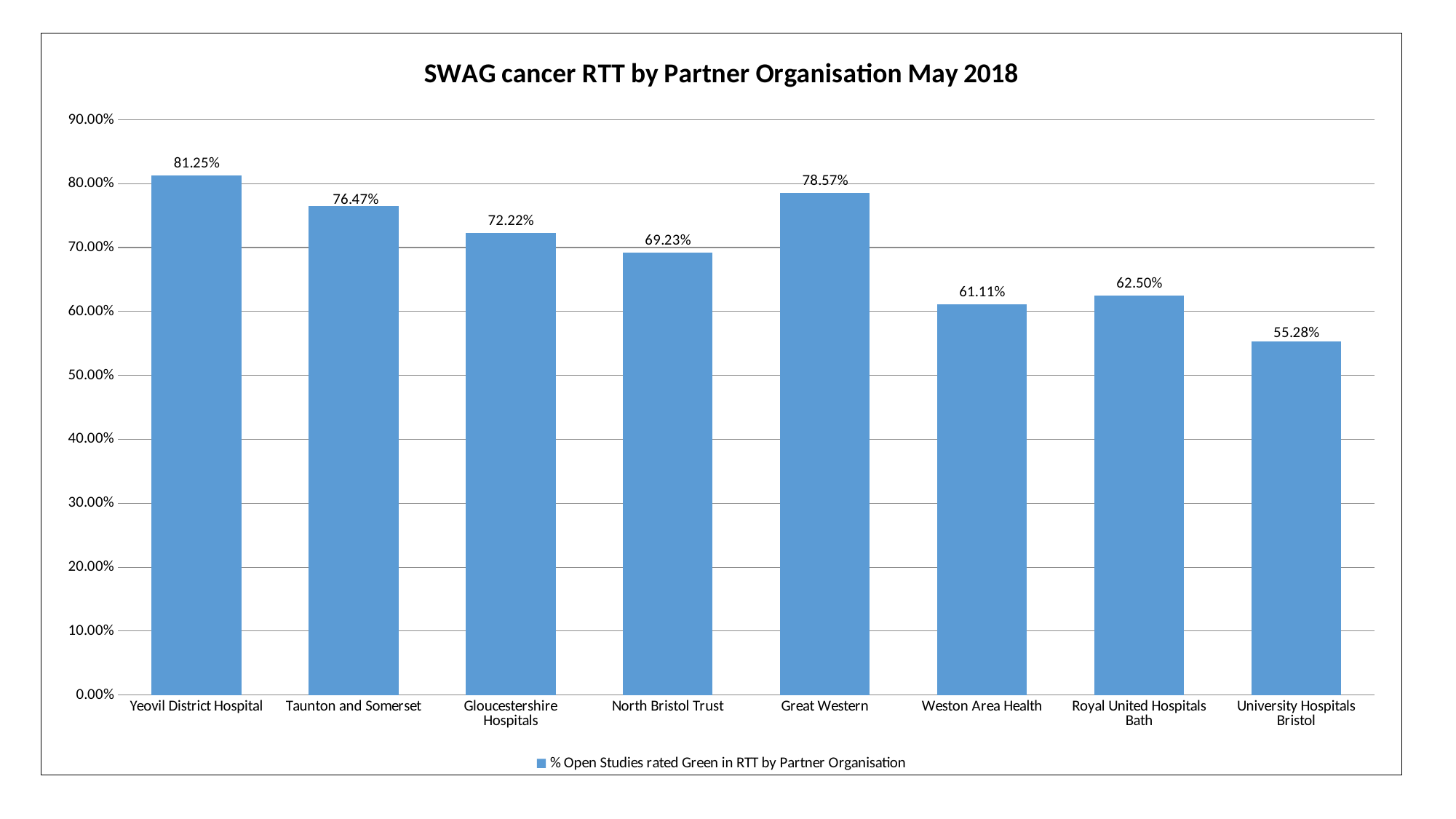
What is the value for Great Western? 78.57% What kind of chart is shown on the slide? bar chart Which is larger, the value for Taunton and Somerset or the value for Gloucestershire Hospitals? Taunton and Somerset What is the title of the chart? SWAG cancer RTT by Partner Organisation May 2018 Which partner organisation has the lowest value? University Hospitals Bristol What is the value for Yeovil District Hospital? 81.25% Which partner organisation has the highest value? Yeovil District Hospital Is the value for North Bristol Trust greater or less than 70.00%? less What is the difference between the values for Yeovil District Hospital and University Hospitals Bristol? 25.97% What is the value for University Hospitals Bristol? 55.28% How many partner organisations are shown on the chart? 8 How many series does the legend list? 1